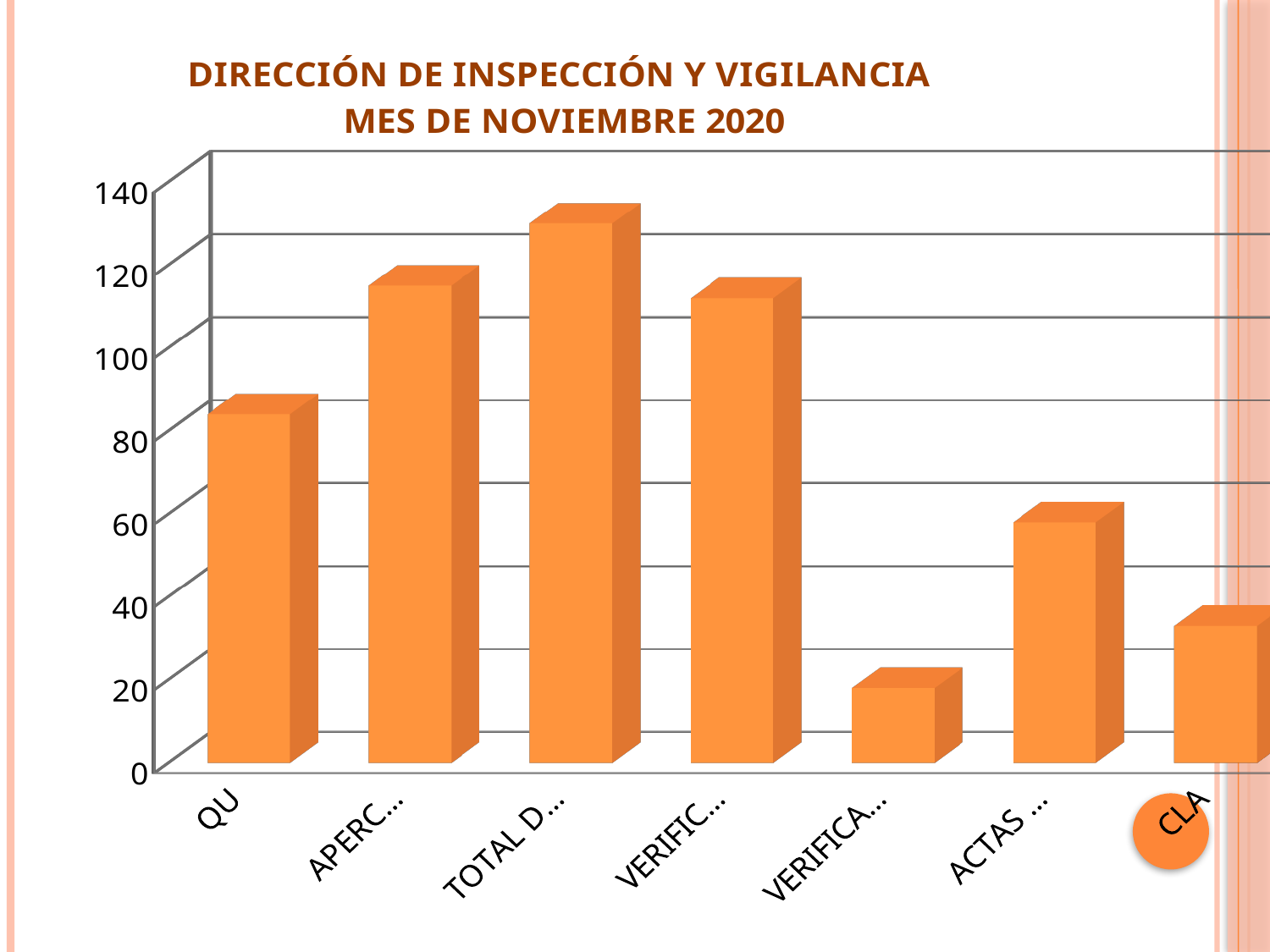
Which category has the lowest bar? VERIFICA... (the fifth bar) Which is larger, the value for QU or the value for CLA? QU Is the value of the fifth bar (VERIFICA...) greater or less than 40? less Is the value of the third bar (TOTAL D...) greater or less than 120? greater Which category has the highest bar? TOTAL D... (the third bar) What is the title of the chart? DIRECCIÓN DE INSPECCIÓN Y VIGILANCIA MES DE NOVIEMBRE 2020 Is the value for QU greater or less than 100? less Which is larger, the first bar (QU) or the second bar (APERC...)? the second bar (APERC...) What kind of chart is shown on the slide? bar chart How many bars (categories) does the chart show? 7